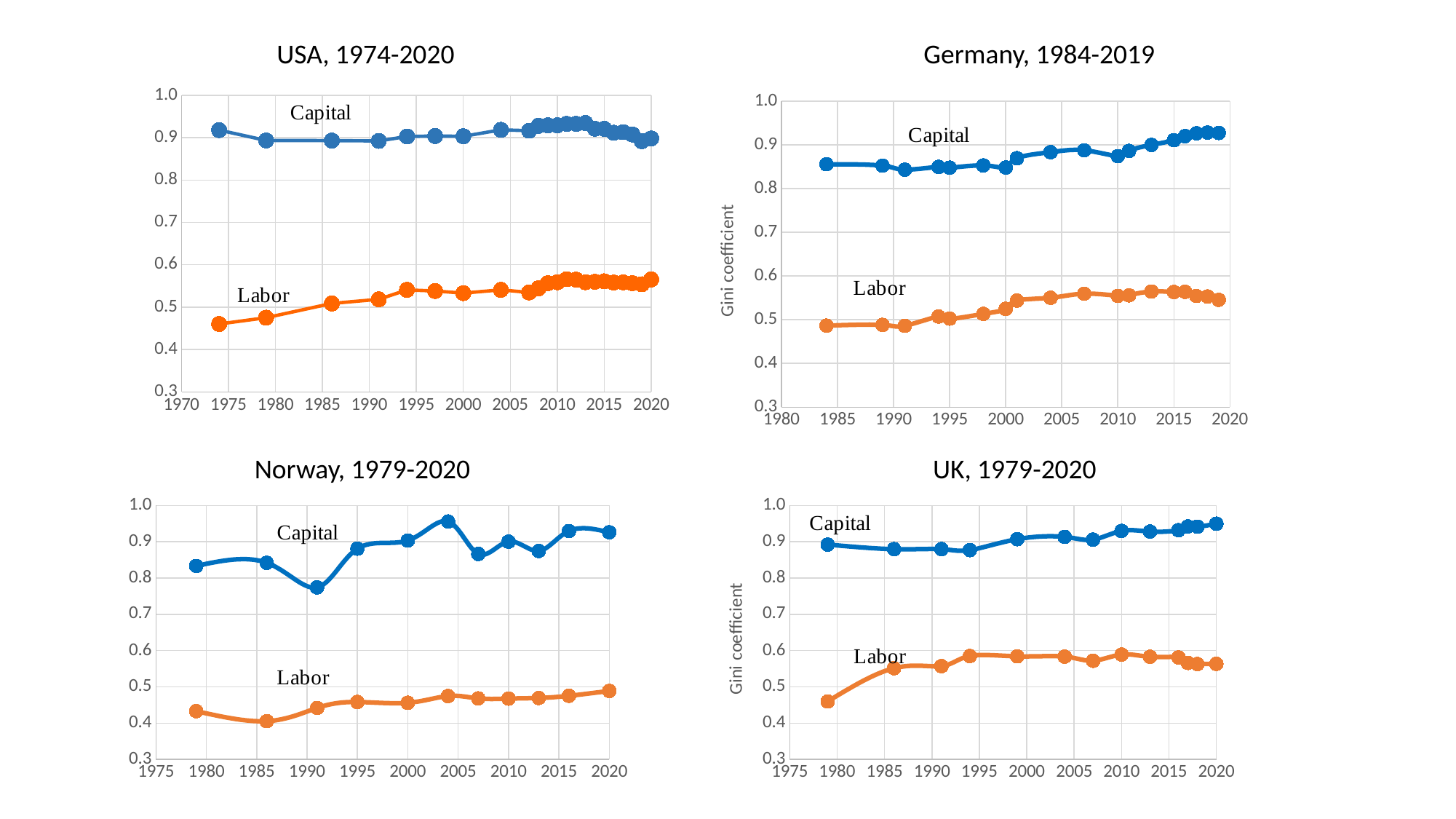
On the Norway, 1979-2020 chart, is the Capital value in 2004 greater or less than 0.9? greater On the USA, 1974-2020 chart, which series has the higher value in 2020, Capital or Labor? Capital On the Germany, 1984-2019 chart, is the Capital value in 2019 greater or less than 0.9? greater How many series are plotted on the Norway, 1979-2020 chart? 2 On the Norway, 1979-2020 chart, is the Capital value in 1991 greater or less than 0.8? less What kind of chart is the USA, 1974-2020 chart? Line chart What is the y-axis label on the Germany, 1984-2019 chart? Gini coefficient On the Germany, 1984-2019 chart, does the Labor series rise or fall overall from 1984 to 2019? Rises On the Norway, 1979-2020 chart, does the Capital series rise or fall between 1986 and 1991? Falls What is the title of the bottom-left chart? Norway, 1979-2020